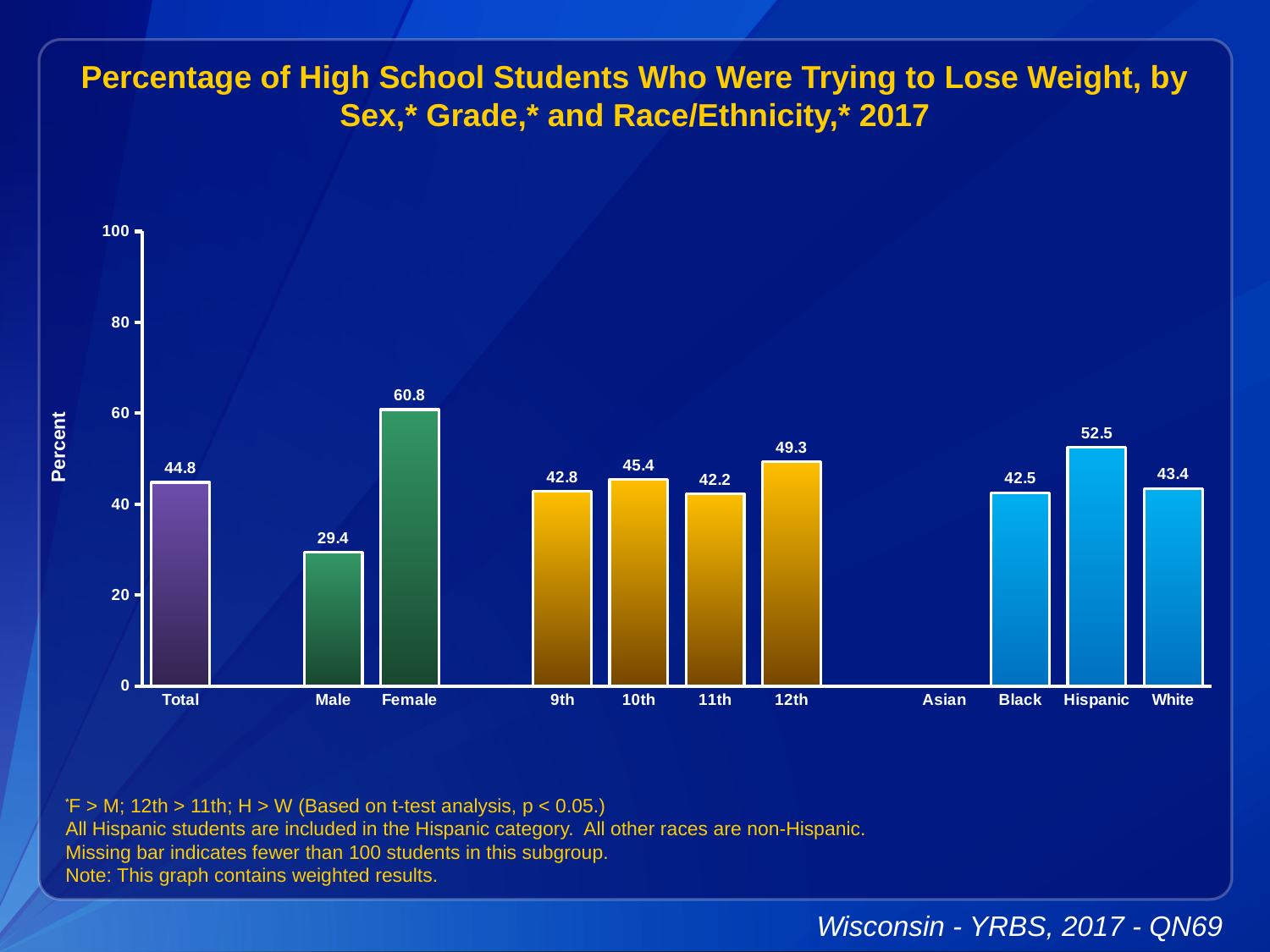
What kind of chart is shown? Bar chart What is the difference between the Female and Male values? 31.4 Which category has the lowest value? Male Is the value for Black greater or less than 40? greater Which category has the highest value? Female What is the value for Female? 60.8 Which category label has no bar plotted? Asian What is the value for 12th grade? 49.3 What is the value for Total? 44.8 How many bars are plotted on the chart? 11 What is the value for Hispanic? 52.5 Which is larger, the value for 10th grade or 11th grade? 10th